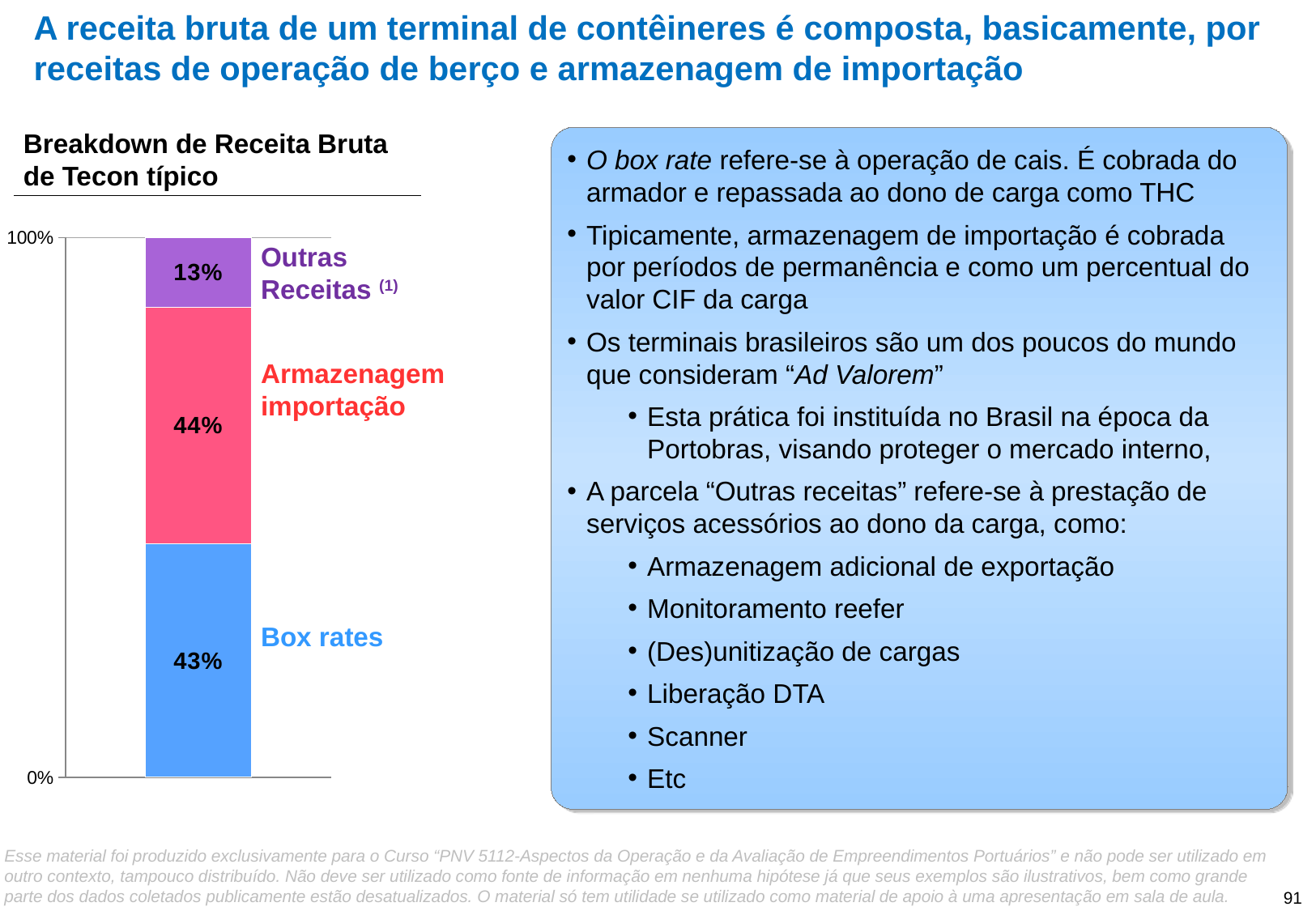
What type of chart is shown on the slide? Stacked bar chart What is the title of the chart? Breakdown de Receita Bruta de Tecon típico Which segment of the stacked bar is the largest? Armazenagem importação Which is larger, the Box rates share or the Outras Receitas share? Box rates How many segments make up the stacked bar? 3 What is the difference between the Armazenagem importação share and the Box rates share? 1% Which segment of the stacked bar is the smallest? Outras Receitas What percentage of gross revenue comes from Box rates? 43% What is the total of the three segments in the stacked bar? 100% What share of the bar is labelled Armazenagem importação? 44% What is the value shown for Outras Receitas? 13% What is the difference between the Box rates share and the Outras Receitas share? 30%